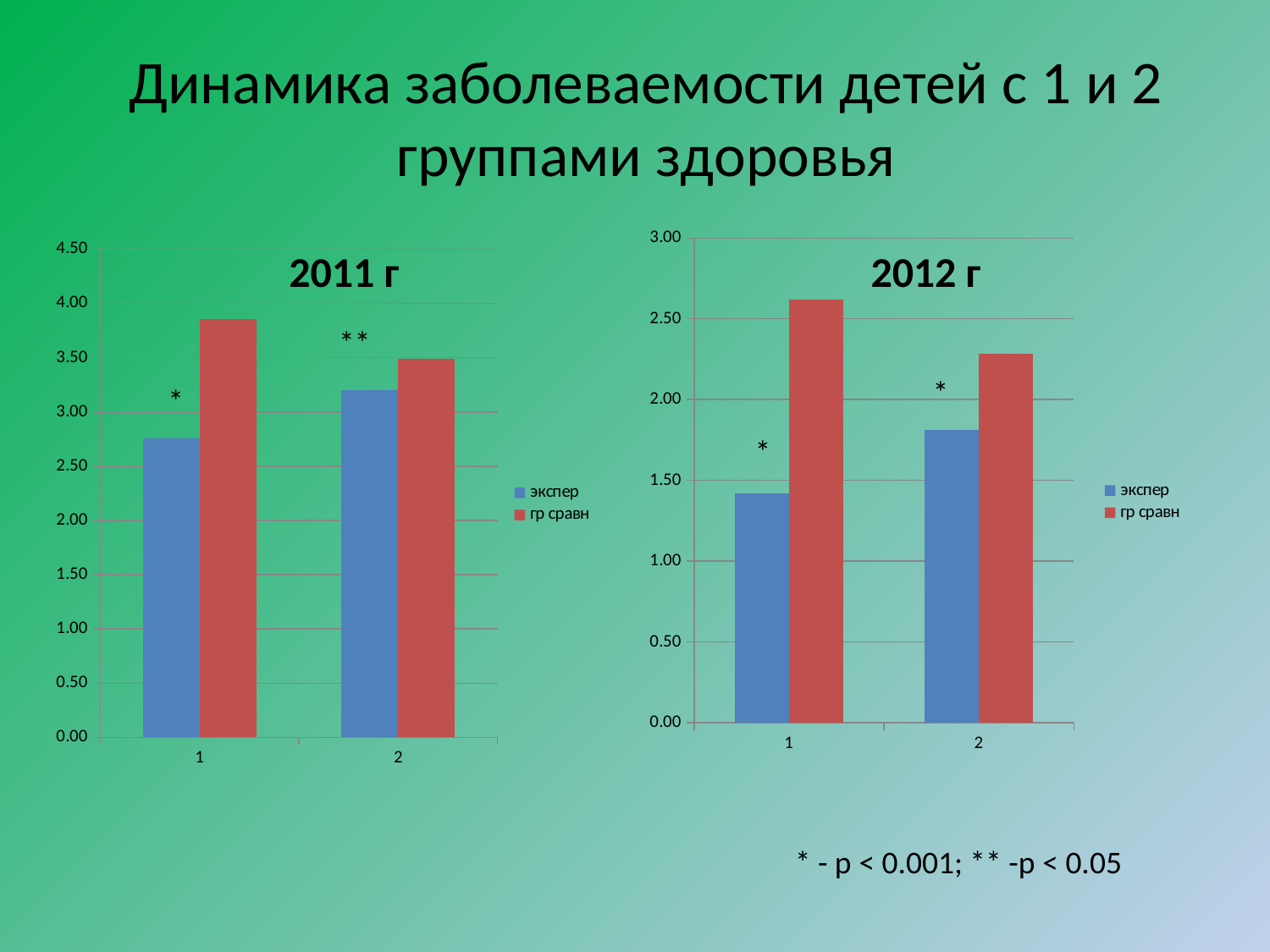
In the "2011 г" chart, is the value for гр сравн in category 1 greater or less than 3.50? greater How many categories are shown on the x axis of the "2011 г" chart? 2 In the "2012 г" chart, is the value for гр сравн in category 2 greater or less than 2.00? greater In the "2012 г" chart, is the value for экспер in category 2 greater or less than 2.00? less In the "2012 г" chart, does the value for гр сравн rise or fall from category 1 to category 2? fall In the "2011 г" chart, for category 2, which series has the larger value, экспер or гр сравн? гр сравн Which colour represents the series экспер in the "2012 г" chart? blue How many series does the legend of the "2012 г" chart list? 2 What type of chart is the "2011 г" chart? bar chart In the "2011 г" chart, which series has the tallest bar overall? гр сравн In the "2012 г" chart, which bar is the lowest? экспер in category 1